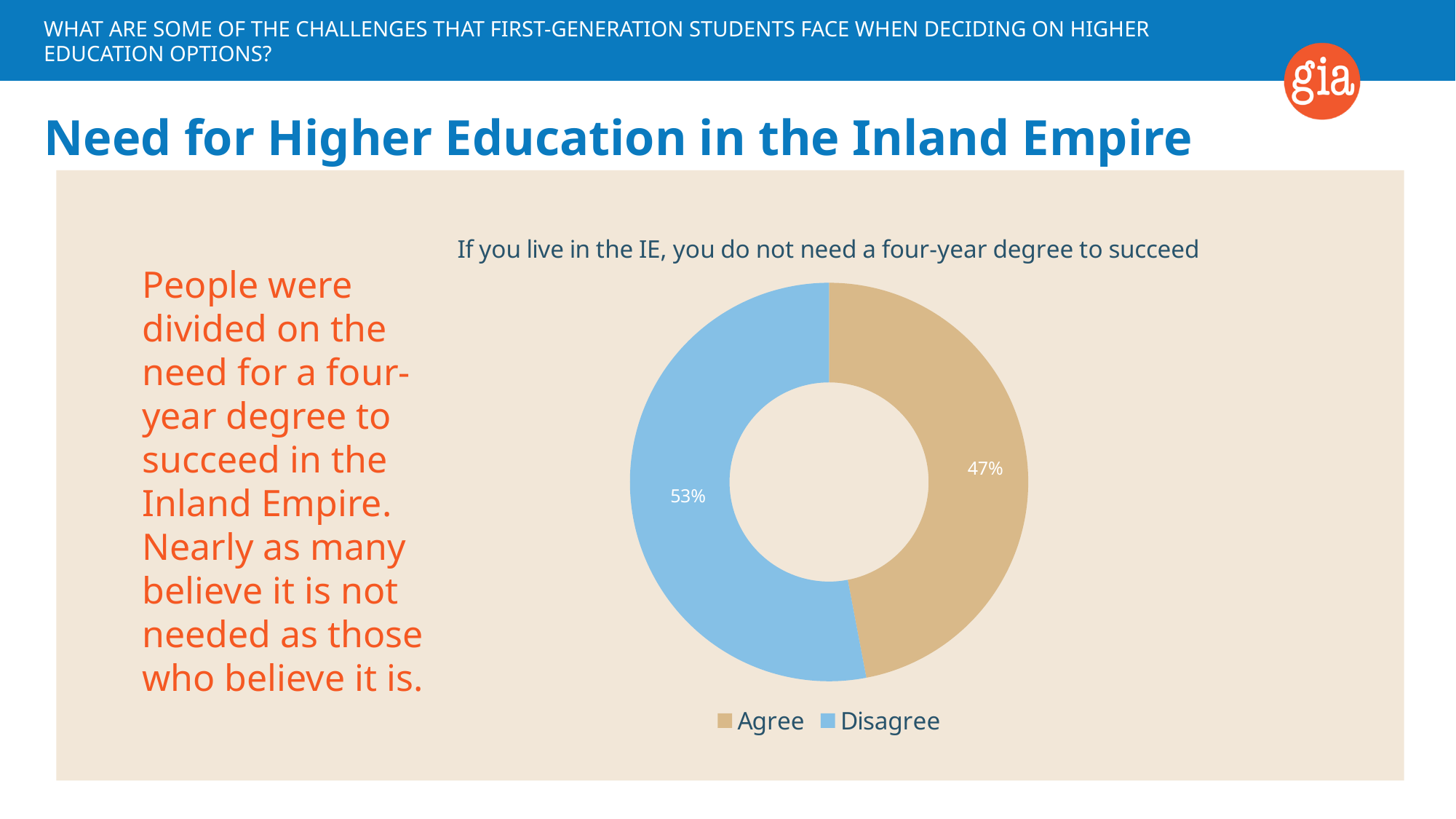
How many categories are shown in the chart? 2 Is the Agree share larger or smaller than the Disagree share? smaller Which response has the larger share of the chart, Agree or Disagree? Disagree Which response has the smaller share of the chart? Agree What percentage of respondents disagree with the statement that you do not need a four-year degree to succeed in the IE? 53% What kind of chart is shown on the slide? Doughnut (pie) chart What percentage of respondents agree that if you live in the IE, you do not need a four-year degree to succeed? 47% What share of the chart does the Agree slice represent? 47% What is the difference in percentage points between the Disagree and Agree shares? 6 percentage points Is the value for Disagree greater or less than 50%? greater Which colour represents the Disagree category in the chart? Blue What is the title of the chart? If you live in the IE, you do not need a four-year degree to succeed